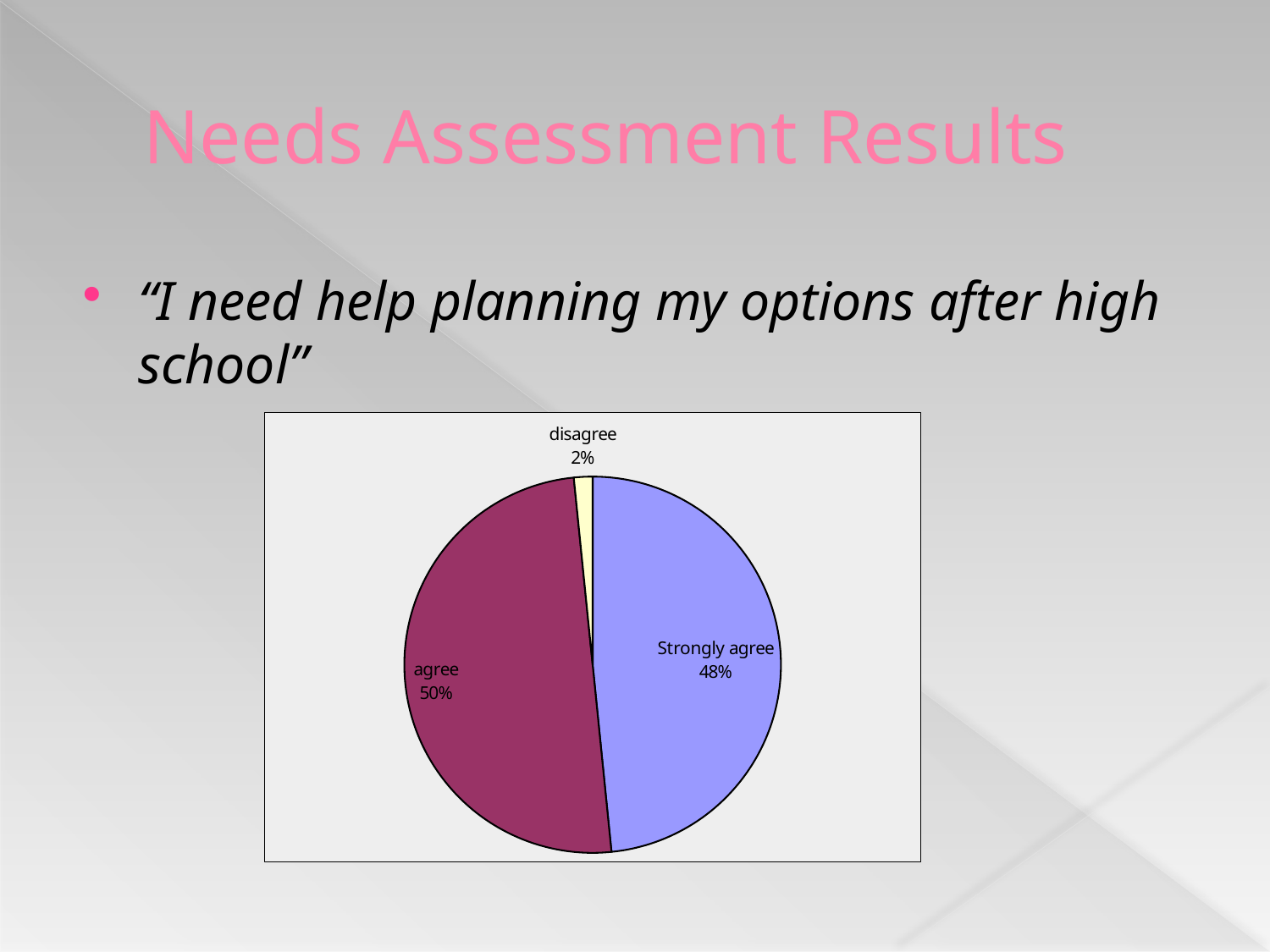
What is the difference in percentage points between "agree" and "Strongly agree"? 2 Which response has the largest share of the pie? agree Which is larger, the share for "Strongly agree" or the share for "disagree"? Strongly agree What is the difference in percentage points between "Strongly agree" and "disagree"? 46 What percentage of respondents chose "Strongly agree"? 48% Which response has the smallest share of the pie? disagree What colour is the "agree" slice of the pie? dark magenta What percentage of respondents chose "agree"? 50% What percentage of respondents chose "disagree"? 2% What is the combined share of "Strongly agree" and "agree"? 98% How many slices does the pie chart have? 3 What kind of chart is shown on the slide? pie chart